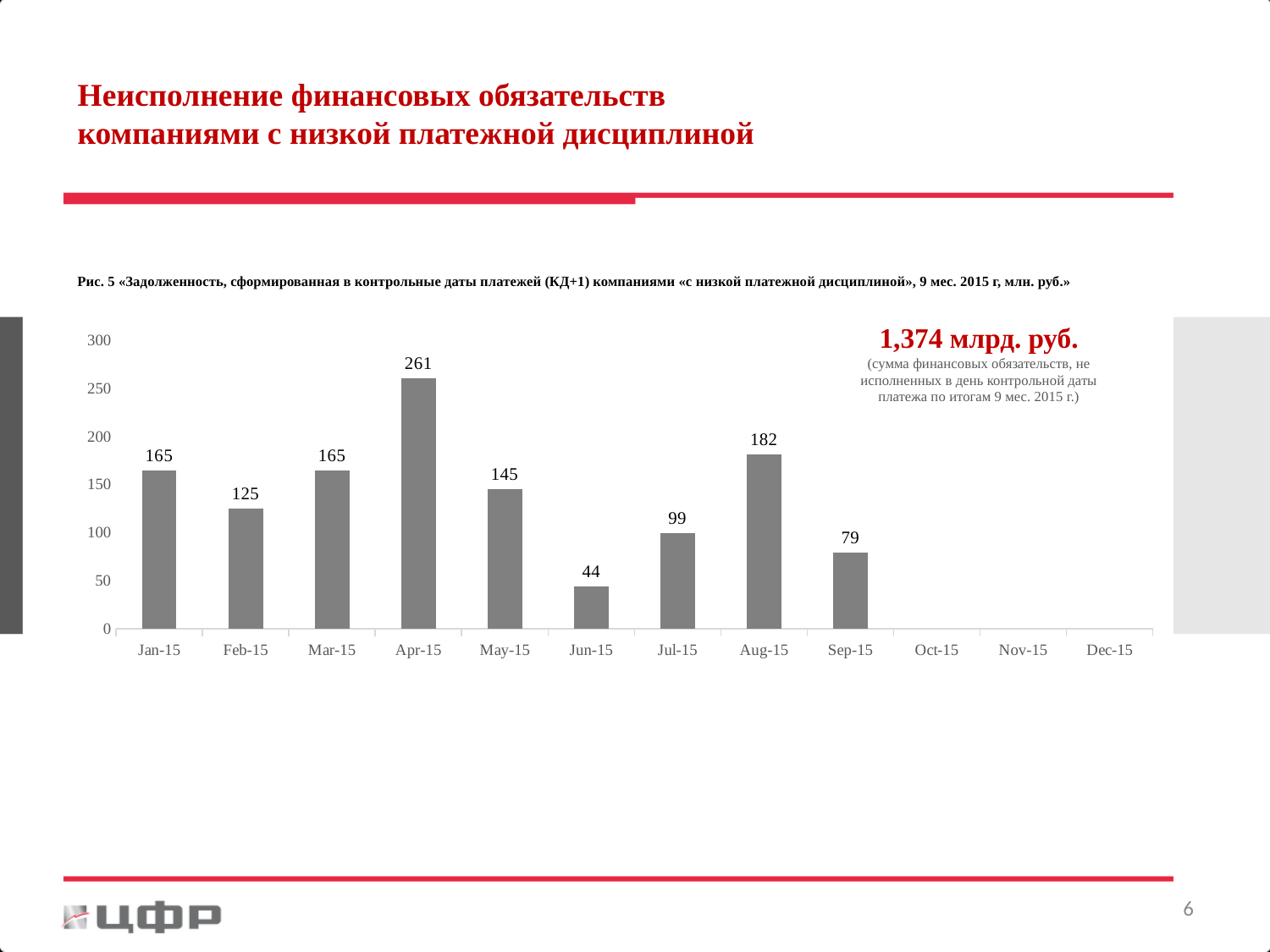
Which is larger, the value for Jul-15 or the value for Sep-15? Jul-15 How many months have a bar plotted on the chart? 9 What total amount in billions of rubles is printed in the upper right of the chart? 1,374 млрд. руб. Which month with a plotted bar has the lowest value? Jun-15 What is the difference between the values for Apr-15 and Aug-15? 79 Which month has the highest value? Apr-15 What is the value for Apr-15? 261 What kind of chart is shown on the slide? bar chart What is the value for Jun-15? 44 What is the value for Aug-15? 182 What is the difference between the values for Jan-15 and Feb-15? 40 Is the value for May-15 greater or less than 100? greater